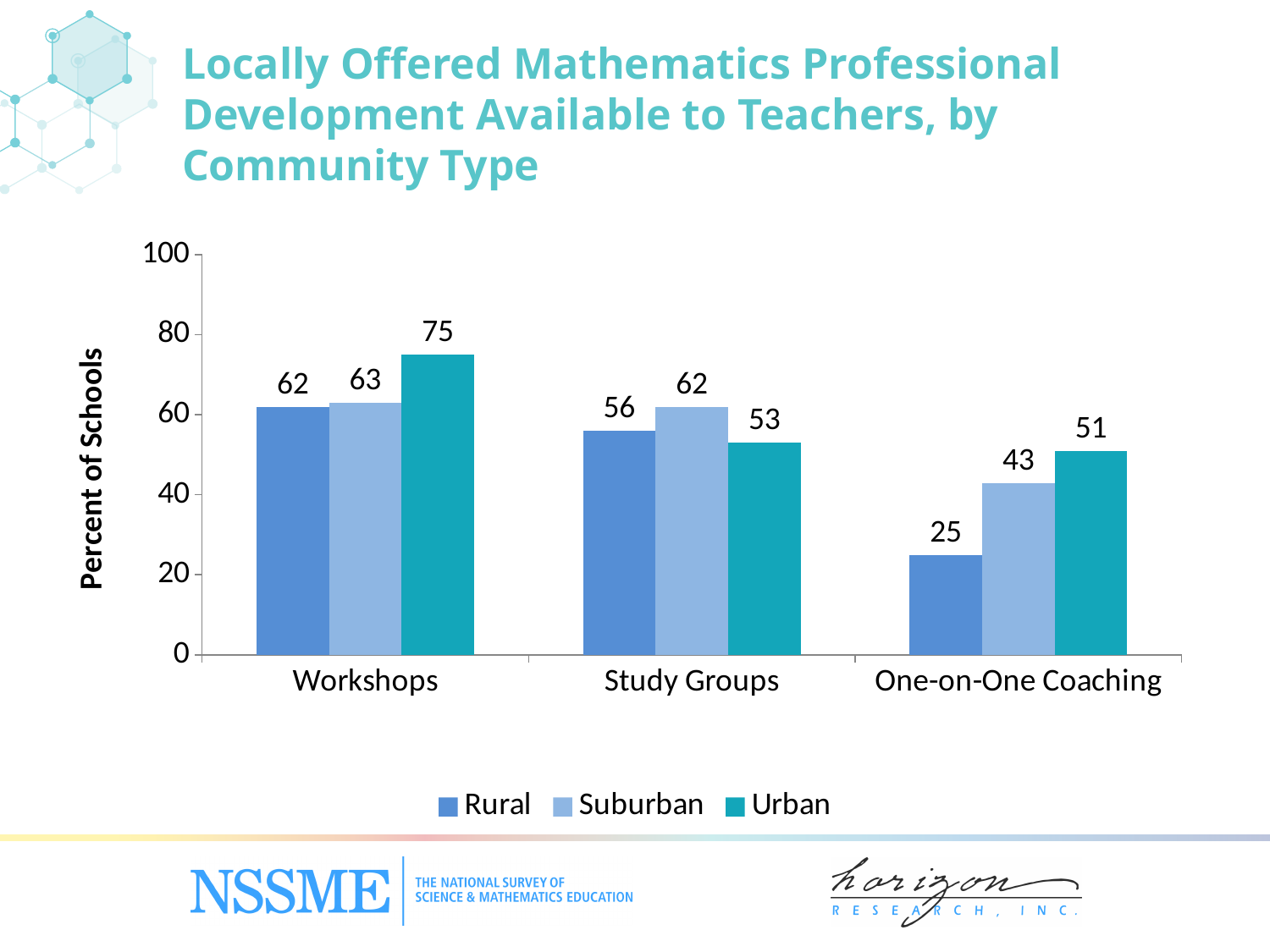
What is the label of the vertical axis? Percent of Schools Which community type has the highest value for Workshops? Urban What is the difference between the Urban and Rural values for One-on-One Coaching? 26 What kind of chart is shown on the slide? Bar chart How many professional development categories are shown on the x axis? 3 Is the Suburban value for One-on-One Coaching greater or less than 40? greater Which community type has the lowest value for One-on-One Coaching? Rural What is the value for Suburban schools in the Study Groups category? 62 What percent of schools in urban communities offer workshops? 75 Which is larger for Study Groups: the Rural value or the Suburban value? Suburban How many series does the legend list? 3 What is the value for Rural schools in the One-on-One Coaching category? 25